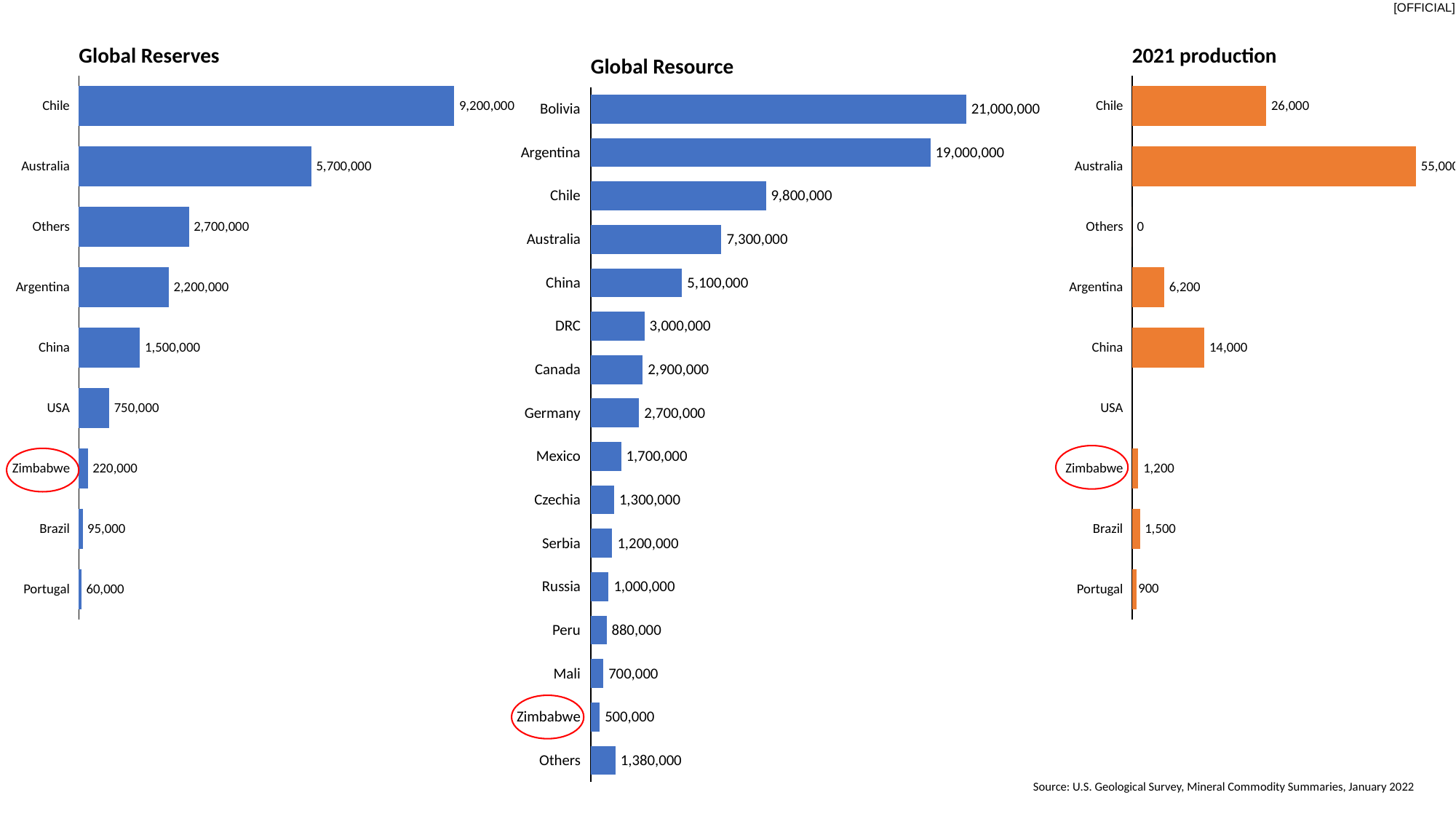
In the Global Resource chart, which is larger, DRC or Canada? DRC In the 2021 production chart, what is the value for China? 14,000 In the 2021 production chart, which country has the highest production? Australia In the Global Reserves chart, what is the value for Chile? 9,200,000 What kind of chart is the 2021 production chart? Bar chart Which country is circled in red on the slide? Zimbabwe In the Global Reserves chart, which country has the lowest reserves? Portugal In the Global Resource chart, what is the value for Germany? 2,700,000 In the Global Resource chart, which country has the highest value? Bolivia In the Global Reserves chart, what is the difference between Australia and Argentina? 3,500,000 In the Global Resource chart, how many categories are plotted? 16 In the 2021 production chart, what is the difference between Chile and Argentina? 19,800